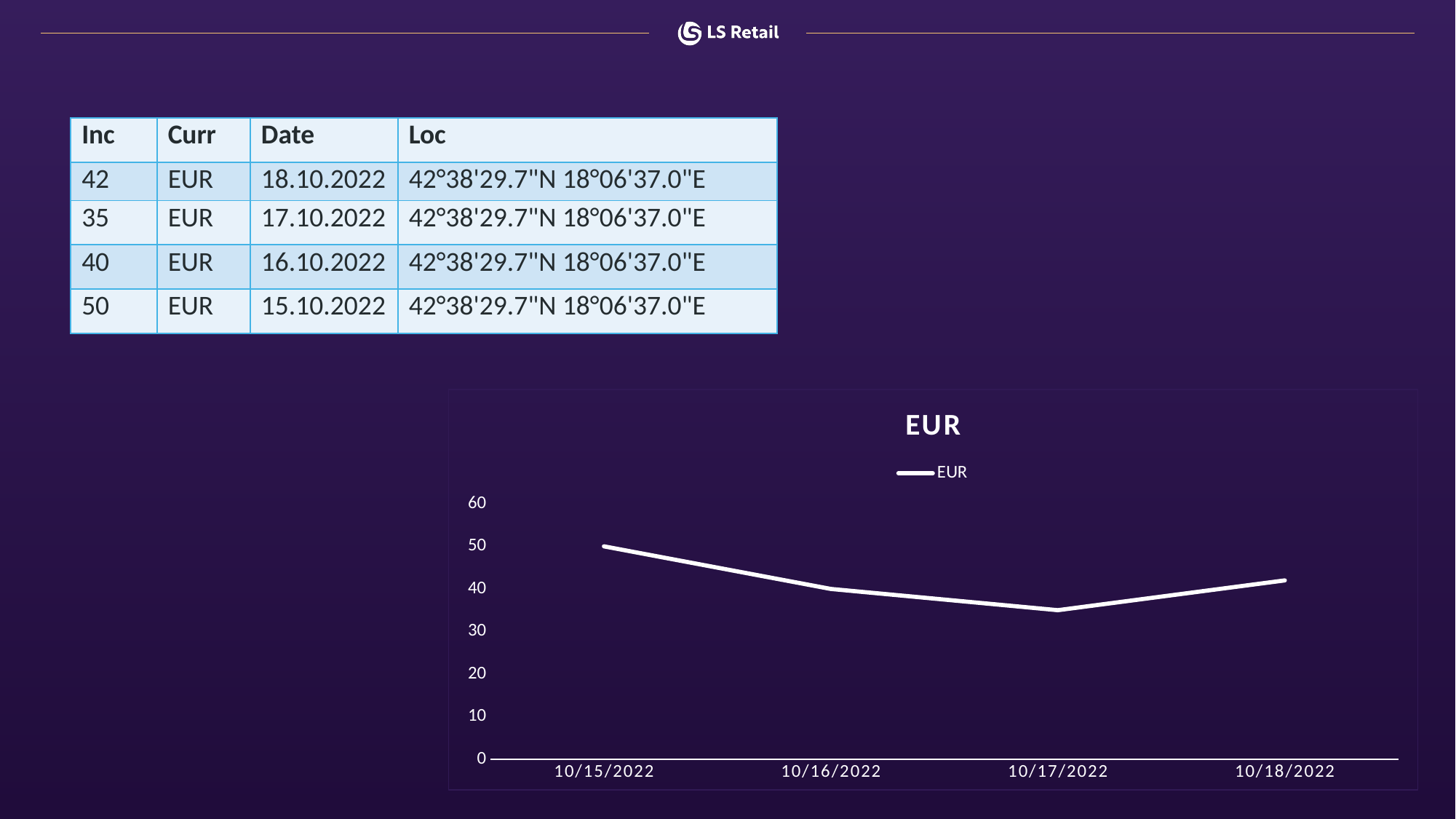
What is the title of the chart? EUR What kind of chart is shown on the slide? line chart Which date has the highest value in the chart? 10/15/2022 Which date has the lowest value in the chart? 10/17/2022 How many series does the chart legend list? 1 How many dates are plotted on the x axis of the chart? 4 Is the value for 10/17/2022 greater or less than 40? less Which is larger, the value for 10/15/2022 or the value for 10/18/2022? 10/15/2022 What is the value for 10/15/2022 in the chart? 50 What is the value for 10/16/2022 in the chart? 40 Does the value rise or fall from 10/15/2022 to 10/17/2022? fall Is the value for 10/18/2022 greater or less than 40? greater